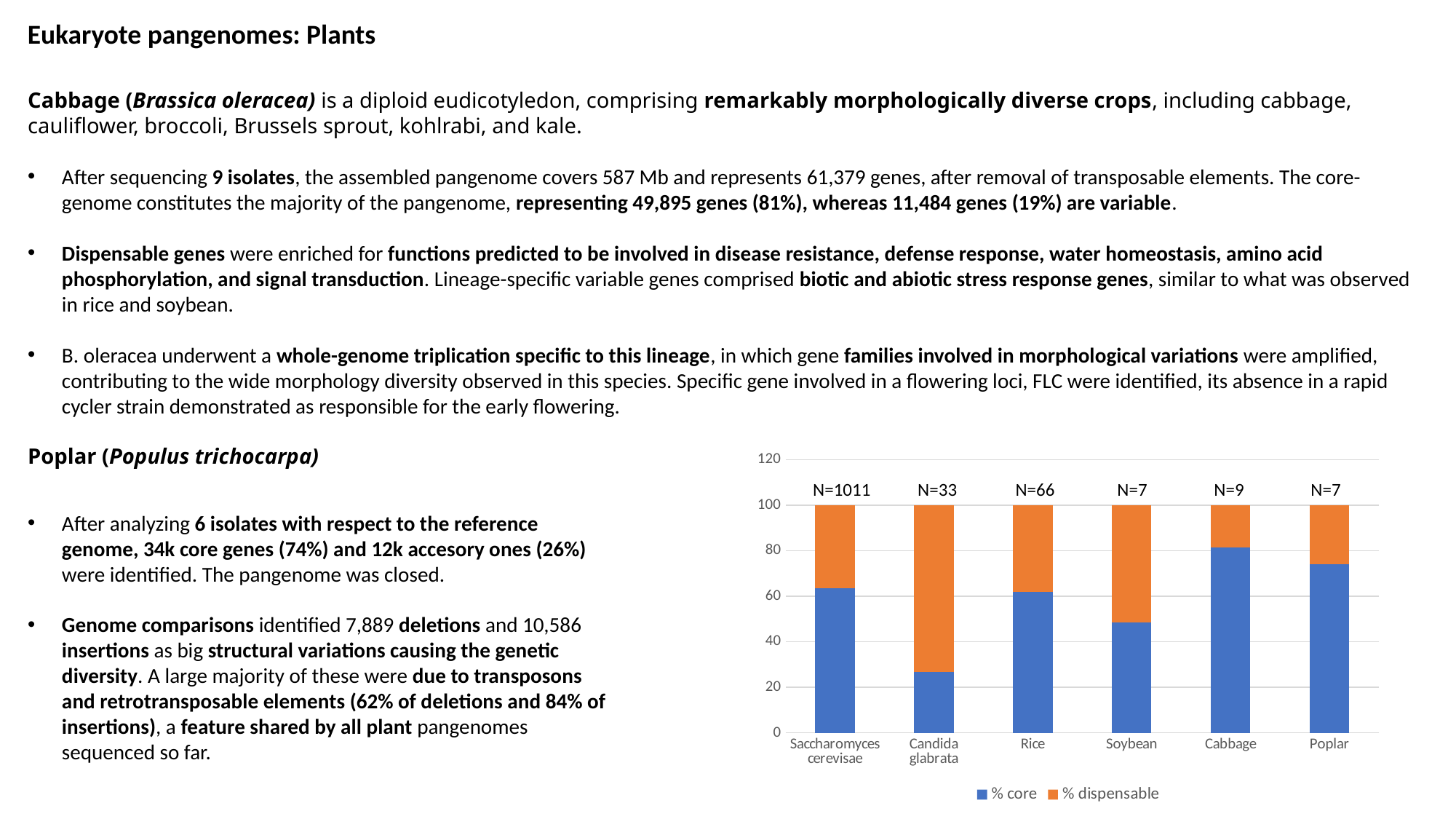
How many categories are shown on the x axis of the chart? 6 Which category has the lowest % core value? Candida glabrata Which colour represents the % dispensable series in the chart? Orange Is the % core value for Soybean greater or less than 60? less What is the N value printed above the Saccharomyces cerevisae bar? N=1011 Which category has the highest % core value? Cabbage What is the total height of the stacked bar for Rice? 100 What is the N value printed above the Rice bar? N=66 Which has the larger % core value, Cabbage or Poplar? Cabbage How many series does the chart legend list? 2 What is the N value printed above the Cabbage bar? N=9 What kind of chart is shown on the slide? Stacked bar chart